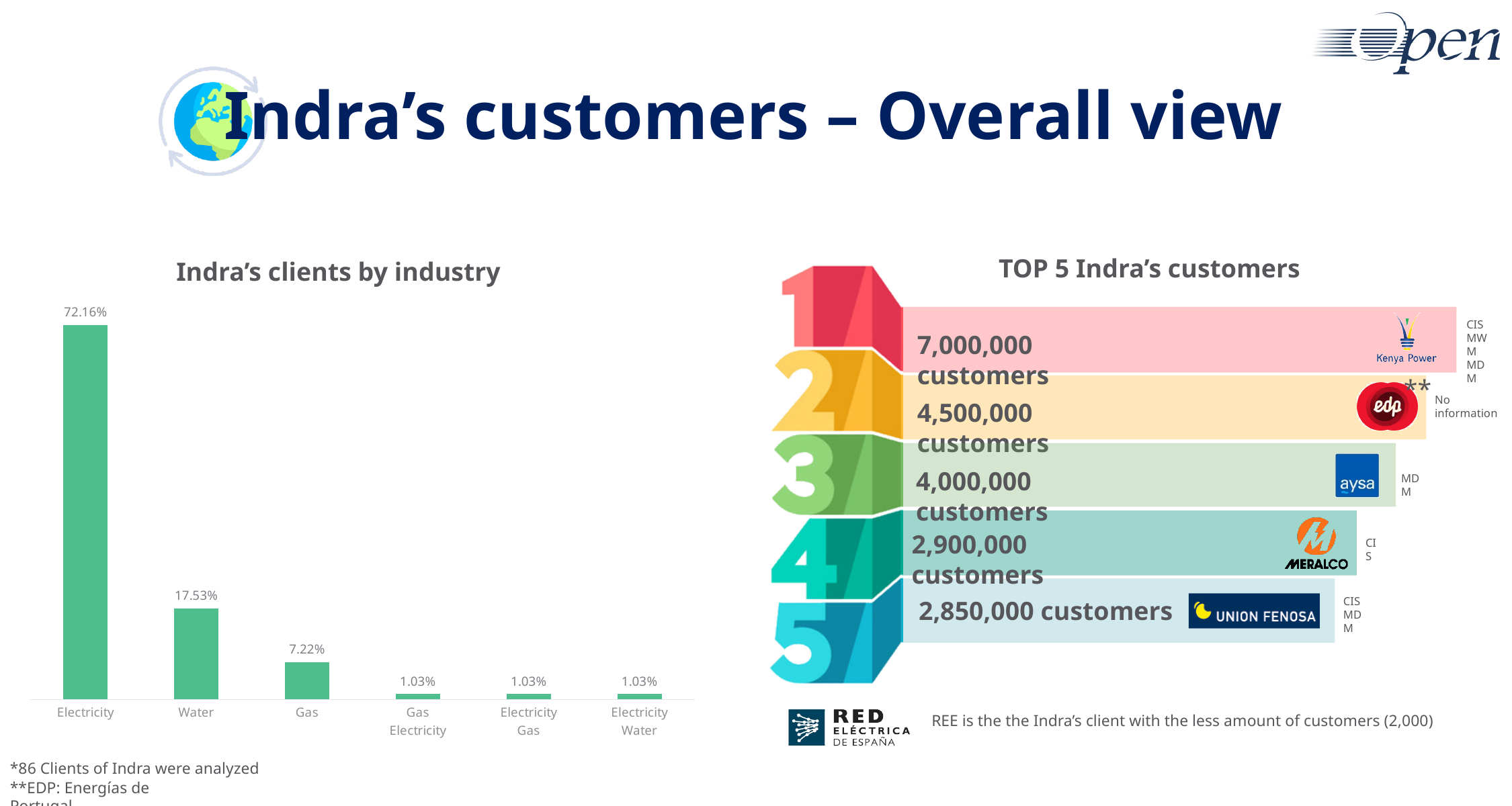
In the 'Indra's clients by industry' chart, what is the difference between the Water and Gas values? 10.31% In the 'TOP 5 Indra's customers' graphic, how many customers does Kenya Power have? 7,000,000 customers How many industry categories are shown in the 'Indra's clients by industry' chart? 6 In the 'Indra's clients by industry' chart, what is the value for Gas? 7.22% In the 'Indra's clients by industry' chart, which is larger, Water or Gas? Water In the 'Indra's clients by industry' chart, what is the difference between the Electricity and Water values? 54.63% In the 'Indra's clients by industry' chart, which industry has the highest share? Electricity In the 'Indra's clients by industry' chart, what is the value for Electricity Water? 1.03% What type of chart is 'Indra's clients by industry'? Bar chart In the 'Indra's clients by industry' chart, what is the value for Electricity? 72.16% In the 'Indra's clients by industry' chart, do the values rise or fall from left to right? Fall In the 'Indra's clients by industry' chart, what is the value for Water? 17.53%